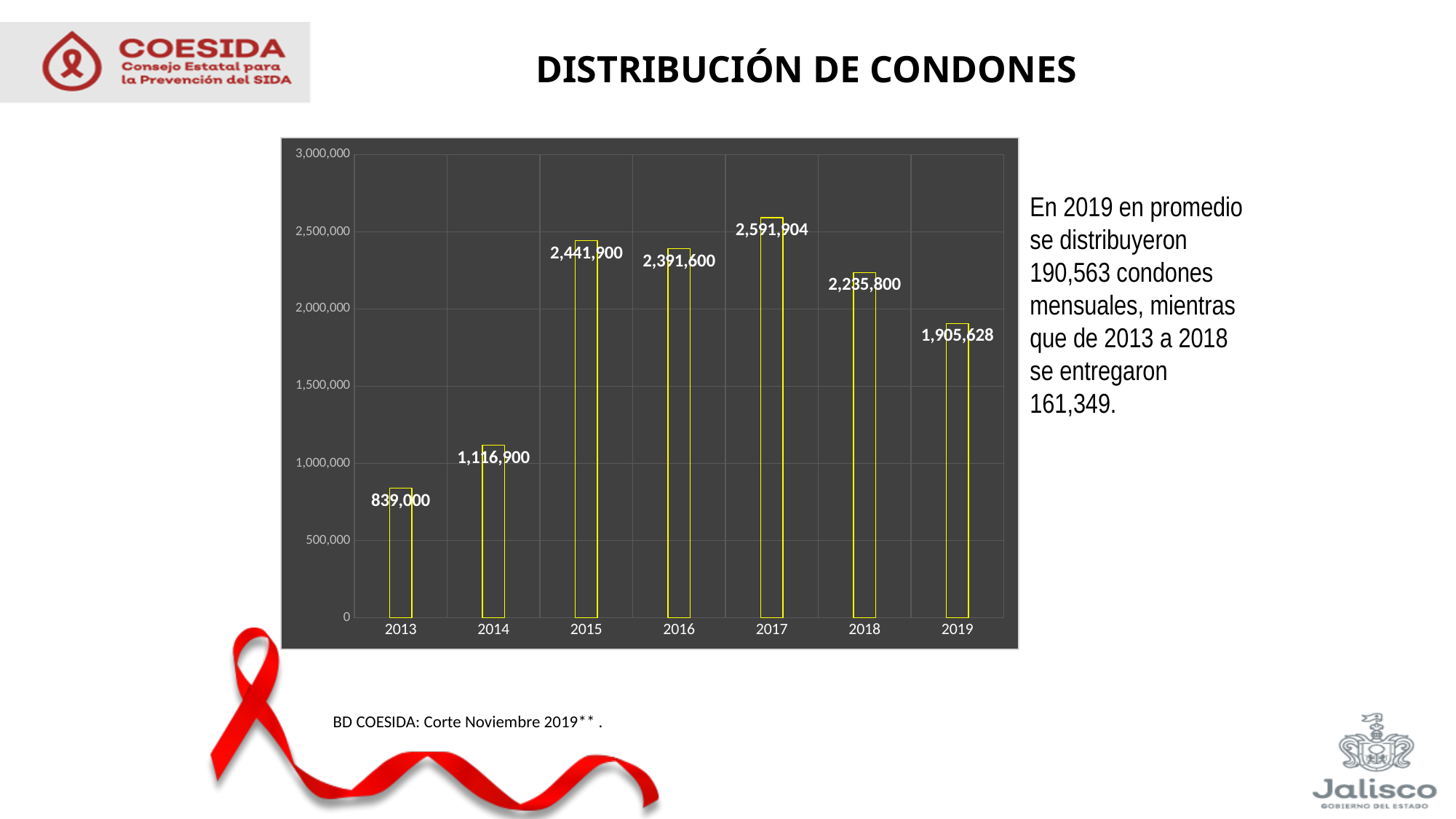
How many years are shown on the x axis of the chart? 7 Which year has the larger value, 2015 or 2018? 2015 Which year has the lowest value in the chart? 2013 What value is shown for 2013 in the condom distribution chart? 839,000 What value is shown for 2017? 2,591,904 Is the value for 2014 greater or less than 1,500,000? less Which year has the highest value in the chart? 2017 What kind of chart is shown on the slide? bar chart What is the difference between the values for 2017 and 2013? 1,752,904 What is the difference between the values for 2018 and 2019? 330,172 What value is shown for 2019? 1,905,628 Do the values rise or fall from 2017 to 2019? fall